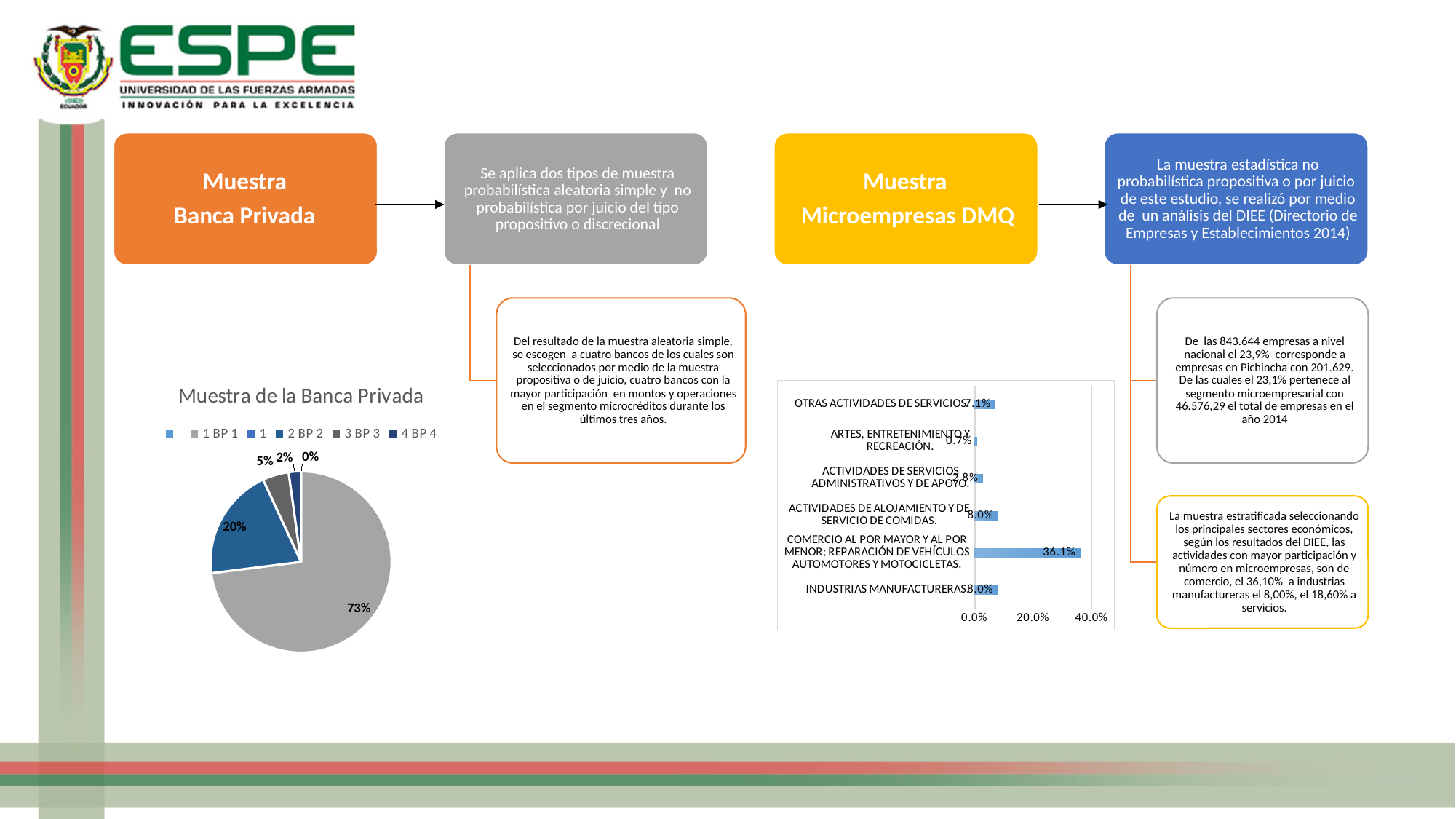
In the bar chart on the right, which category has the lowest value? ARTES, ENTRETENIMIENTO Y RECREACIÓN What kind of chart is the chart on the right of the slide? Bar chart In the bar chart on the right, what is the value for INDUSTRIAS MANUFACTURERAS? 8.0% In the bar chart on the right, is the value for COMERCIO AL POR MAYOR Y AL POR MENOR greater or less than 20.0%? greater In the bar chart on the right, which category has the highest value? COMERCIO AL POR MAYOR Y AL POR MENOR; REPARACIÓN DE VEHÍCULOS AUTOMOTORES Y MOTOCICLETAS In the bar chart on the right, what is the value for ACTIVIDADES DE SERVICIOS ADMINISTRATIVOS Y DE APOYO? 2.8% In the pie chart titled 'Muestra de la Banca Privada', what is the share of the largest slice? 73% In the bar chart on the right, what is the value for COMERCIO AL POR MAYOR Y AL POR MENOR; REPARACIÓN DE VEHÍCULOS AUTOMOTORES Y MOTOCICLETAS? 36.1% What is the title of the pie chart on the left of the slide? Muestra de la Banca Privada In the bar chart on the right, how many categories are shown? 6 In the bar chart on the right, what is the value for ARTES, ENTRETENIMIENTO Y RECREACIÓN? 0.7% In the bar chart on the right, what is the difference between the value for COMERCIO AL POR MAYOR Y AL POR MENOR and the value for INDUSTRIAS MANUFACTURERAS? 28.1%